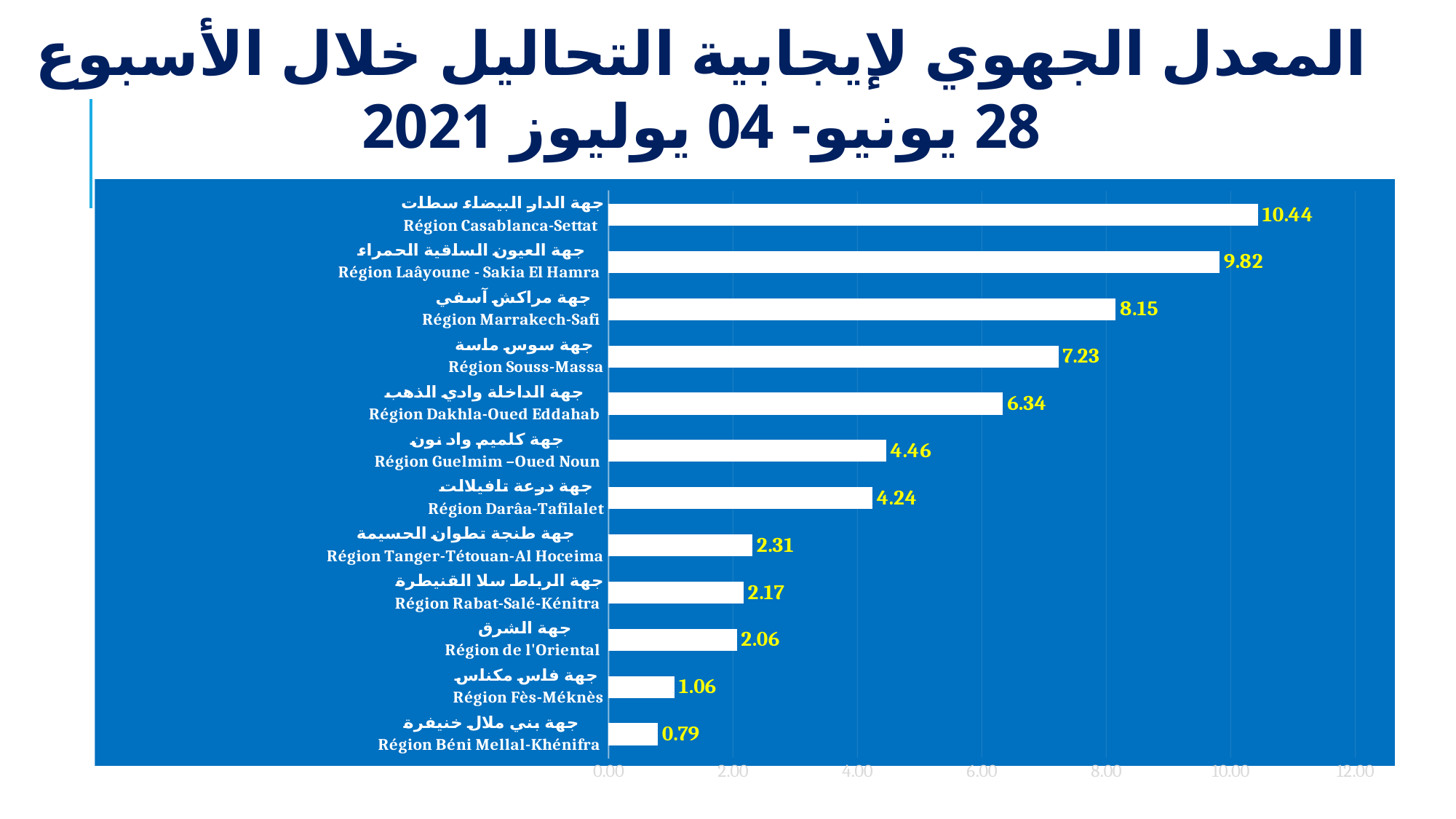
Which region has the lowest value? Région Béni Mellal-Khénifra What is the highest value shown on the x axis? 12.00 What is the difference between the values for Région Tanger-Tétouan-Al Hoceima and Région Rabat-Salé-Kénitra? 0.14 How many regions are shown in the chart? 12 Which is larger, the value for Région Marrakech-Safi or Région Dakhla-Oued Eddahab? Région Marrakech-Safi Which region has the highest value? Région Casablanca-Settat What is the difference between the values for Région Casablanca-Settat and Région Laâyoune - Sakia El Hamra? 0.62 What is the value for Région Fès-Méknès? 1.06 Is the value for Région Guelmim –Oued Noun greater or less than 4.00? greater What is the value for Région Casablanca-Settat? 10.44 What is the value for Région Souss-Massa? 7.23 What kind of chart is shown on the slide? bar chart